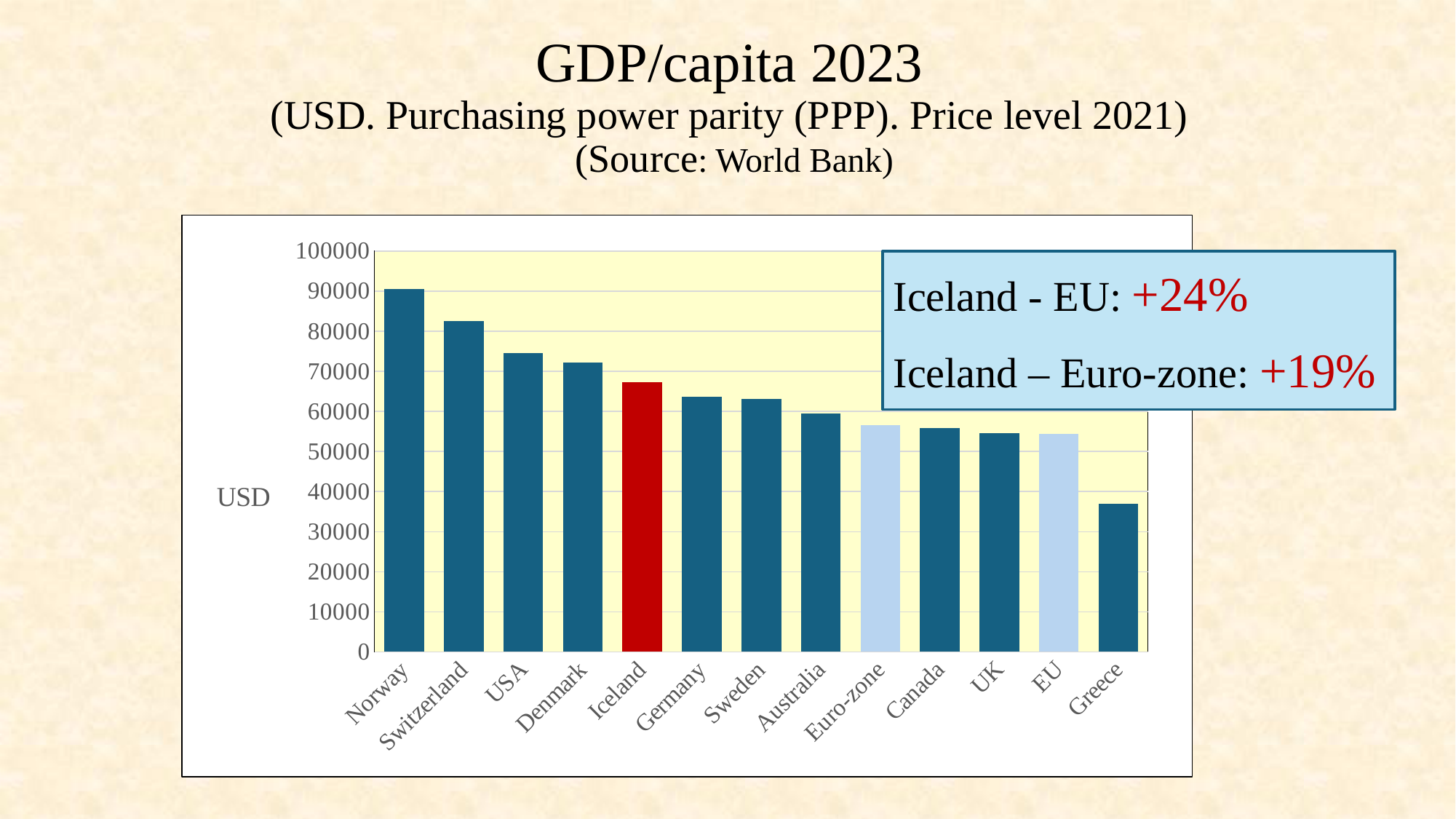
Do the values rise or fall moving from left to right along the x axis? fall Which has a higher GDP per capita, Switzerland or USA? Switzerland Which country has the highest GDP per capita in the chart? Norway How many countries or regions are shown on the x axis of the chart? 13 Is the value for USA greater or less than 70000? greater Is the value for Greece greater or less than 40000? less What kind of chart is shown on the slide? bar chart Which country's bar is coloured red in the chart? Iceland Is the value for Iceland greater or less than 70000? less According to the text box on the chart, by what percentage is Iceland's GDP per capita above the EU's? +24% Which country has the lowest GDP per capita in the chart? Greece